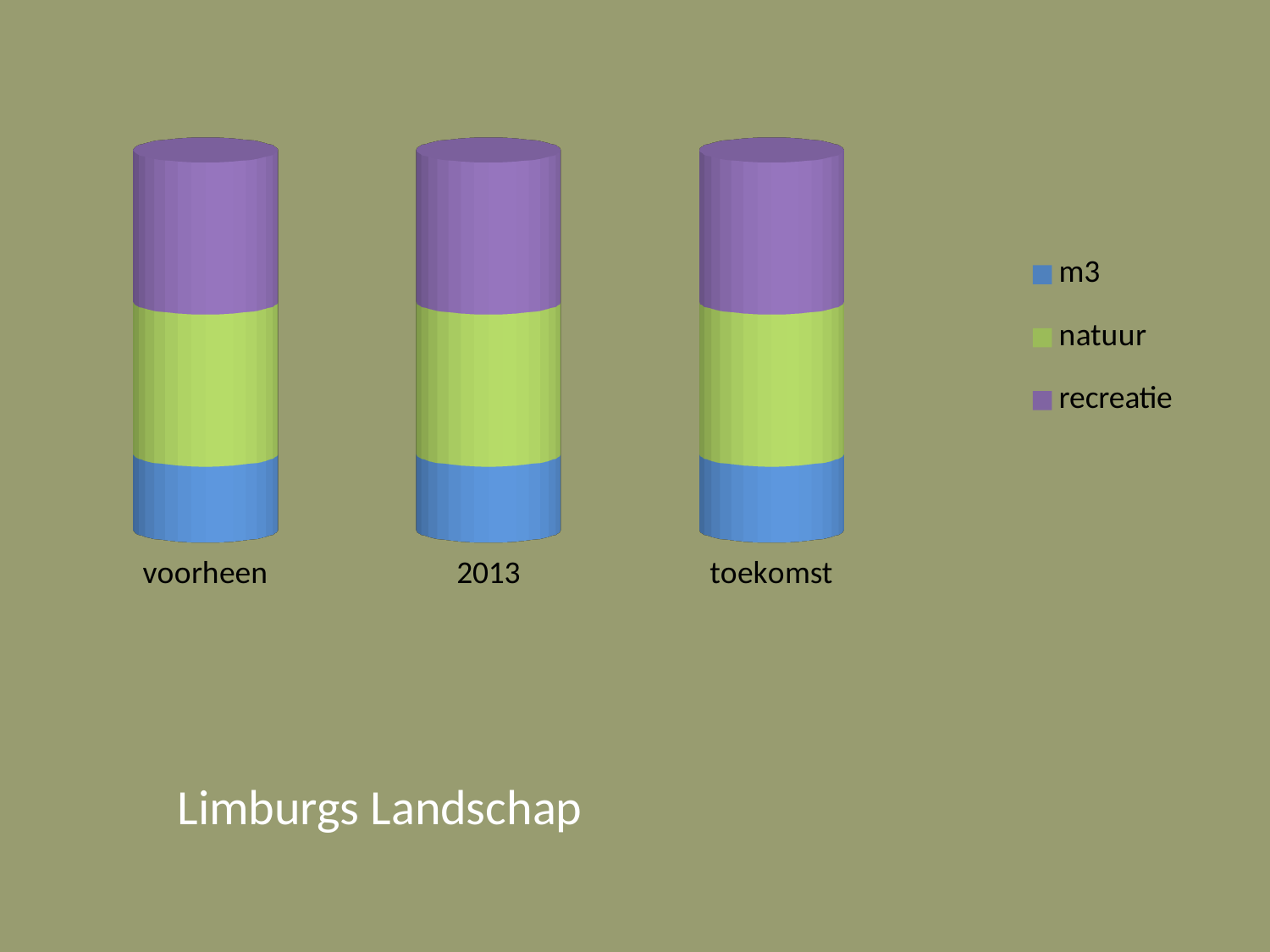
What are the three categories shown along the x axis of the chart? voorheen, 2013, toekomst Which series forms the bottom segment of each stacked bar? m3 What kind of chart is shown on the slide? stacked bar chart How many series does the chart's legend list? 3 Which series forms the top segment of each stacked bar? recreatie How many categories are shown along the x axis of the chart? 3 In the bar for toekomst, which segment is larger: m3 or natuur? natuur Which series is shown in purple in the chart? recreatie